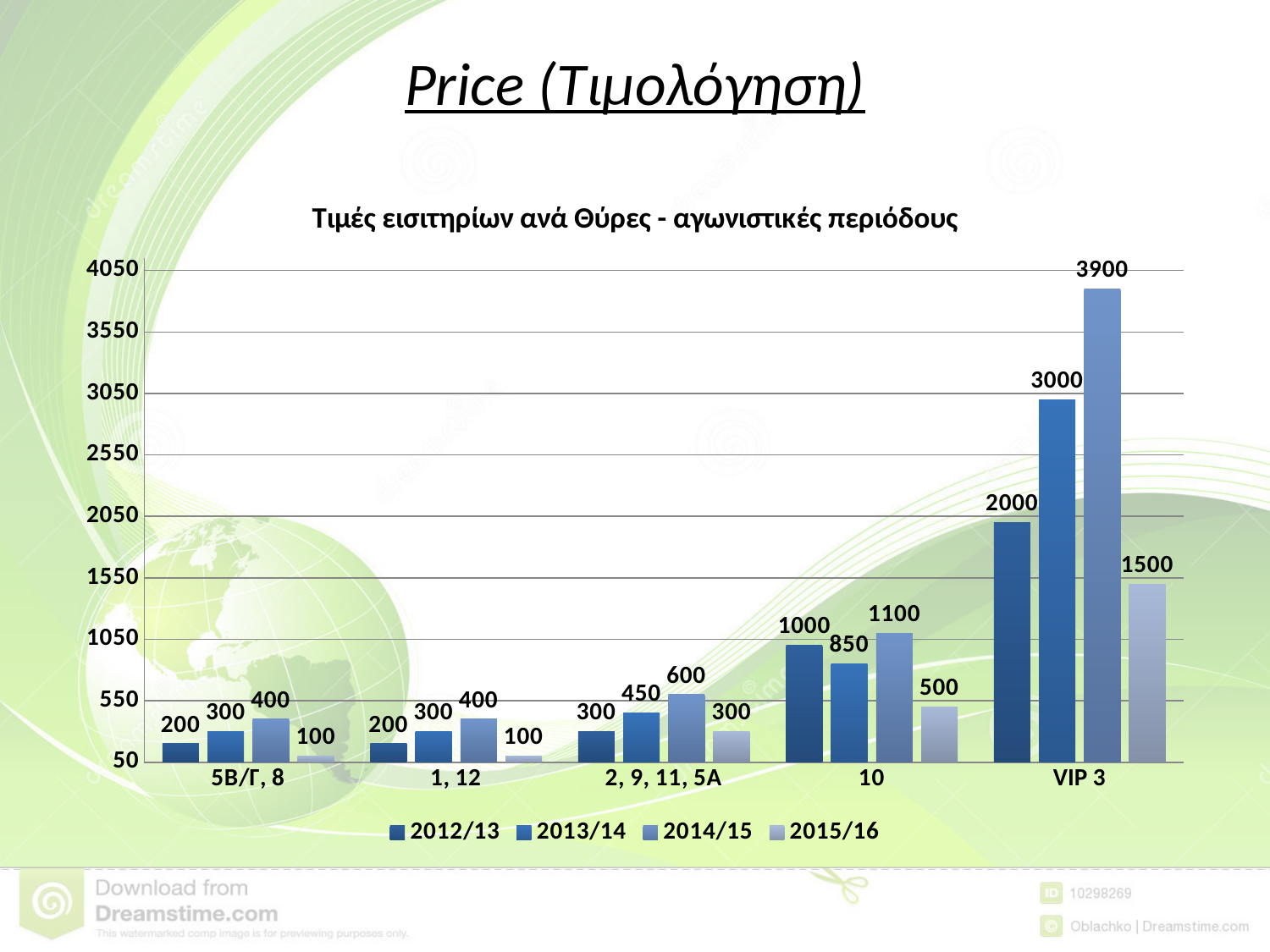
What is the value for 2, 9, 11, 5Α in the 2015/16 series? 300 What is the value for category 10 in the 2013/14 series? 850 What is the difference between the 2014/15 and 2013/14 values for VIP 3? 900 Which series has the lowest value for VIP 3? 2015/16 What is the difference between the 2014/15 and 2015/16 values for category 10? 600 What is the title of the chart? Τιμές εισιτηρίων ανά Θύρες - αγωνιστικές περιόδους Which category has the highest value in the 2012/13 series? VIP 3 Which is larger for category 10: the 2012/13 value or the 2013/14 value? 2012/13 What is the value for VIP 3 in the 2014/15 series? 3900 How many series does the legend list? 4 How many categories are shown on the x axis? 5 What kind of chart is shown on the slide? Bar chart